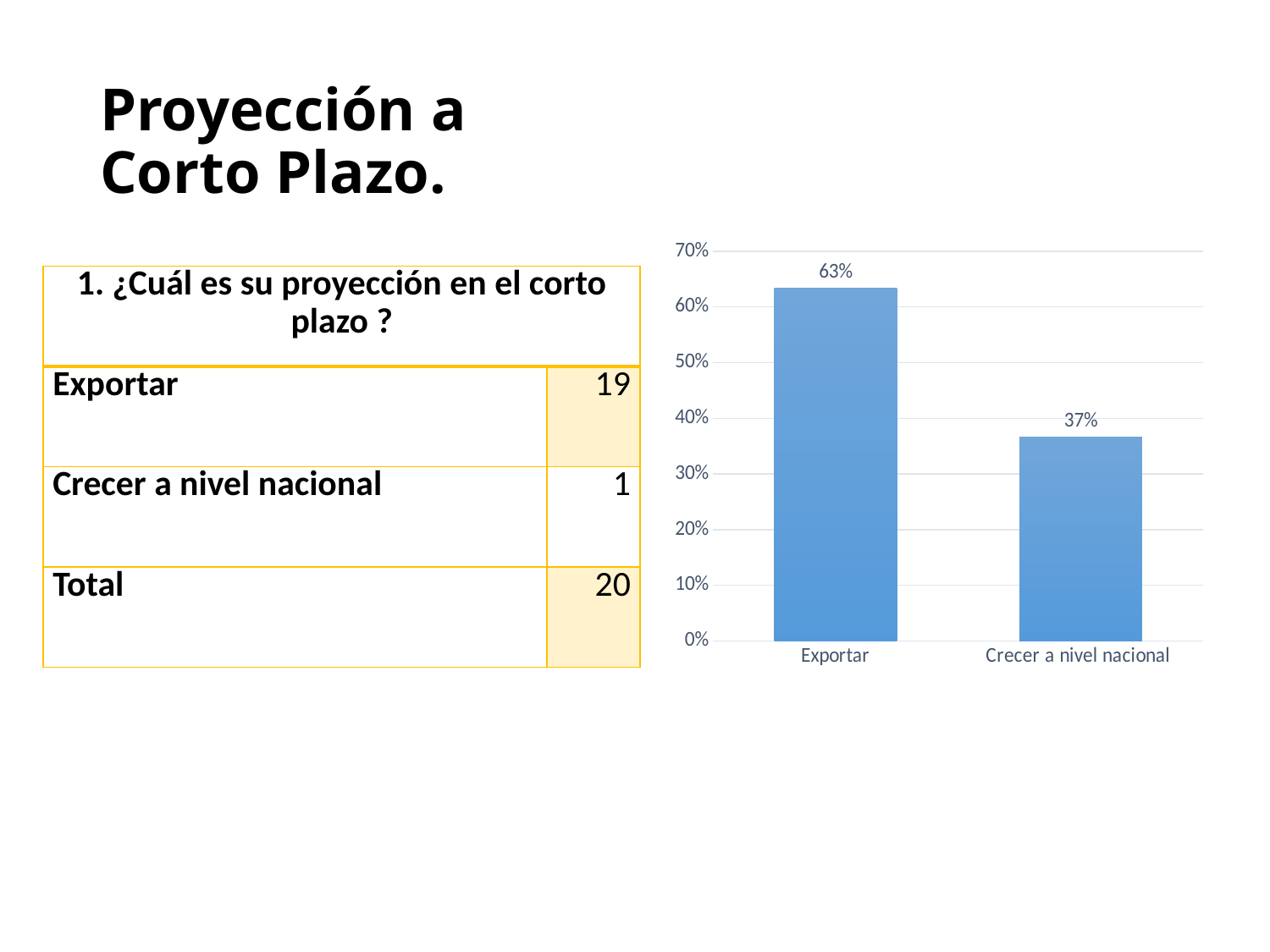
What colour are the bars in the chart? blue Is the value for Exportar greater or less than 60%? greater Which is larger in the chart, Exportar or Crecer a nivel nacional? Exportar What is the difference between the values for Exportar and Crecer a nivel nacional in the chart? 26% What value does the chart show for Crecer a nivel nacional? 37% What value does the chart show for Exportar? 63% What kind of chart is shown on the slide? bar chart How many categories are shown in the chart? 2 Which category has the lowest value in the chart? Crecer a nivel nacional What is the highest value shown on the chart's vertical axis? 70% Is the value for Crecer a nivel nacional greater or less than 40%? less Which category has the highest value in the chart? Exportar